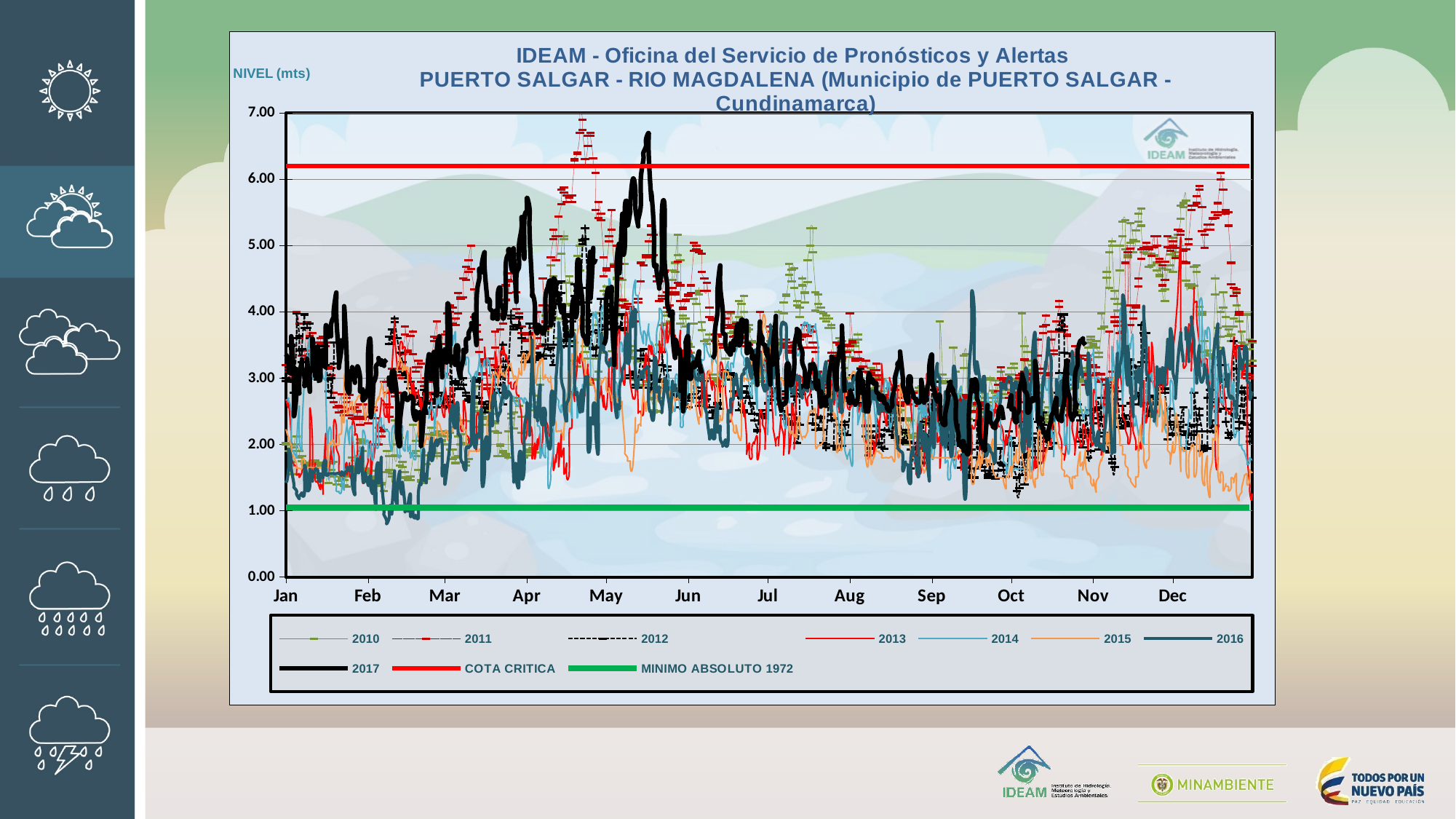
What is the label of the y axis? NIVEL (mts) What is the lowest value shown on the y axis? 0.00 Is the COTA CRITICA line greater or less than 6.00? greater What colour is the COTA CRITICA line? red What kind of chart is shown on the slide? line chart How many months are labelled along the x axis? 12 What is the highest value shown on the y axis? 7.00 Is the MINIMO ABSOLUTO 1972 line greater or less than 2.00? less Which month is the first label on the x axis? Jan Which is higher on the chart, the COTA CRITICA line or the MINIMO ABSOLUTO 1972 line? COTA CRITICA How many entries does the chart legend list? 10 Is the peak of the 2017 series in late May greater or less than 6.00? greater